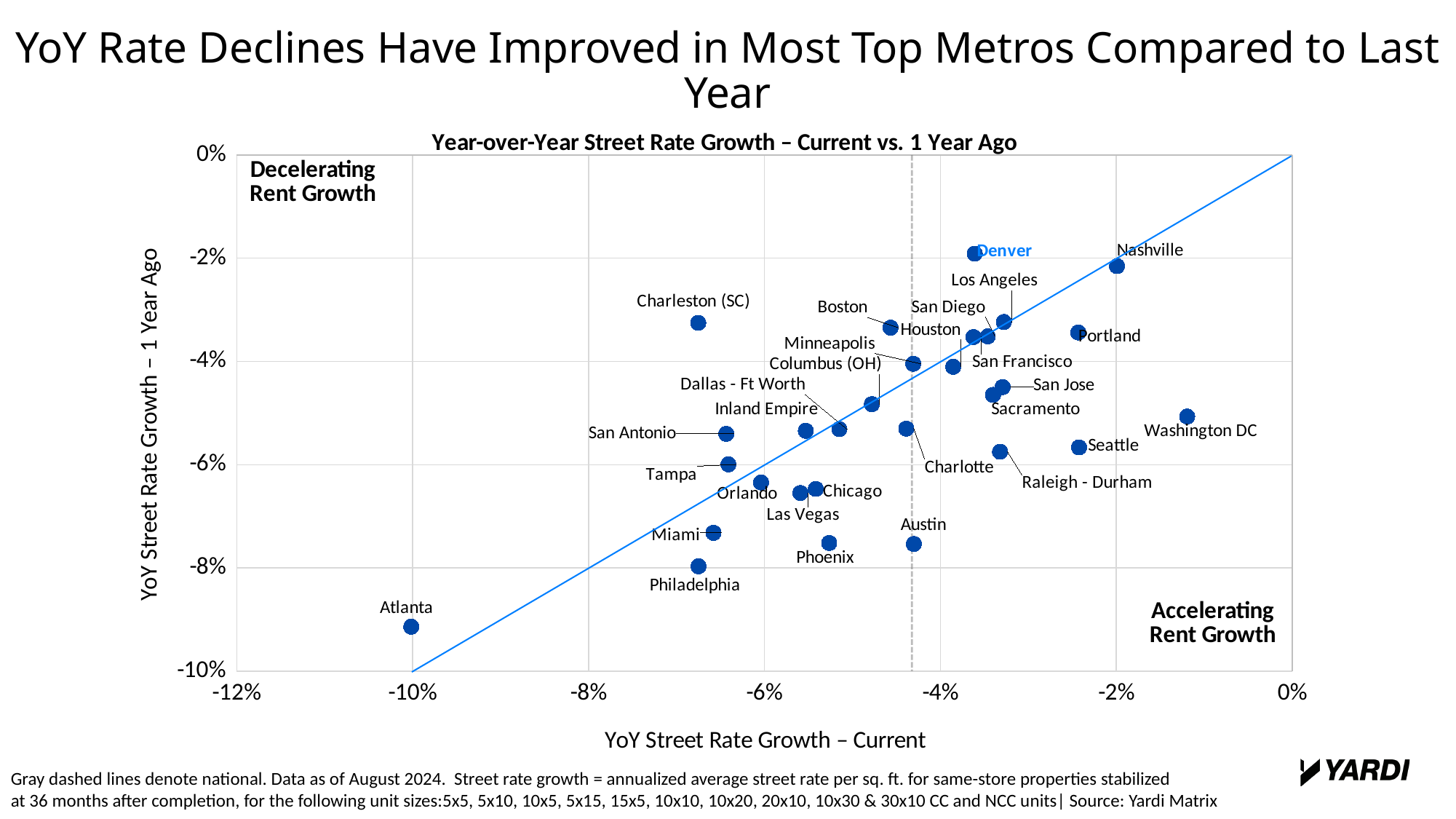
Which metro had the higher YoY street rate growth 1 year ago, Charleston (SC) or Philadelphia? Charleston (SC) Which metro has the highest current YoY street rate growth (furthest right on the x axis)? Washington DC What kind of chart is shown on the slide? Scatter chart Which metro has the lowest current YoY street rate growth (furthest left on the x axis)? Atlanta Is the current YoY street rate growth for Atlanta greater or less than -8%? less Which metro has the higher current YoY street rate growth, Atlanta or Washington DC? Washington DC What is the title of the chart? Year-over-Year Street Rate Growth – Current vs. 1 Year Ago Is the YoY street rate growth 1 year ago for Charleston (SC) greater or less than -4%? greater Which metro has the lowest YoY street rate growth 1 year ago (lowest on the y axis)? Atlanta Is the YoY street rate growth 1 year ago for Austin greater or less than -6%? less What is the label of the x axis? YoY Street Rate Growth – Current